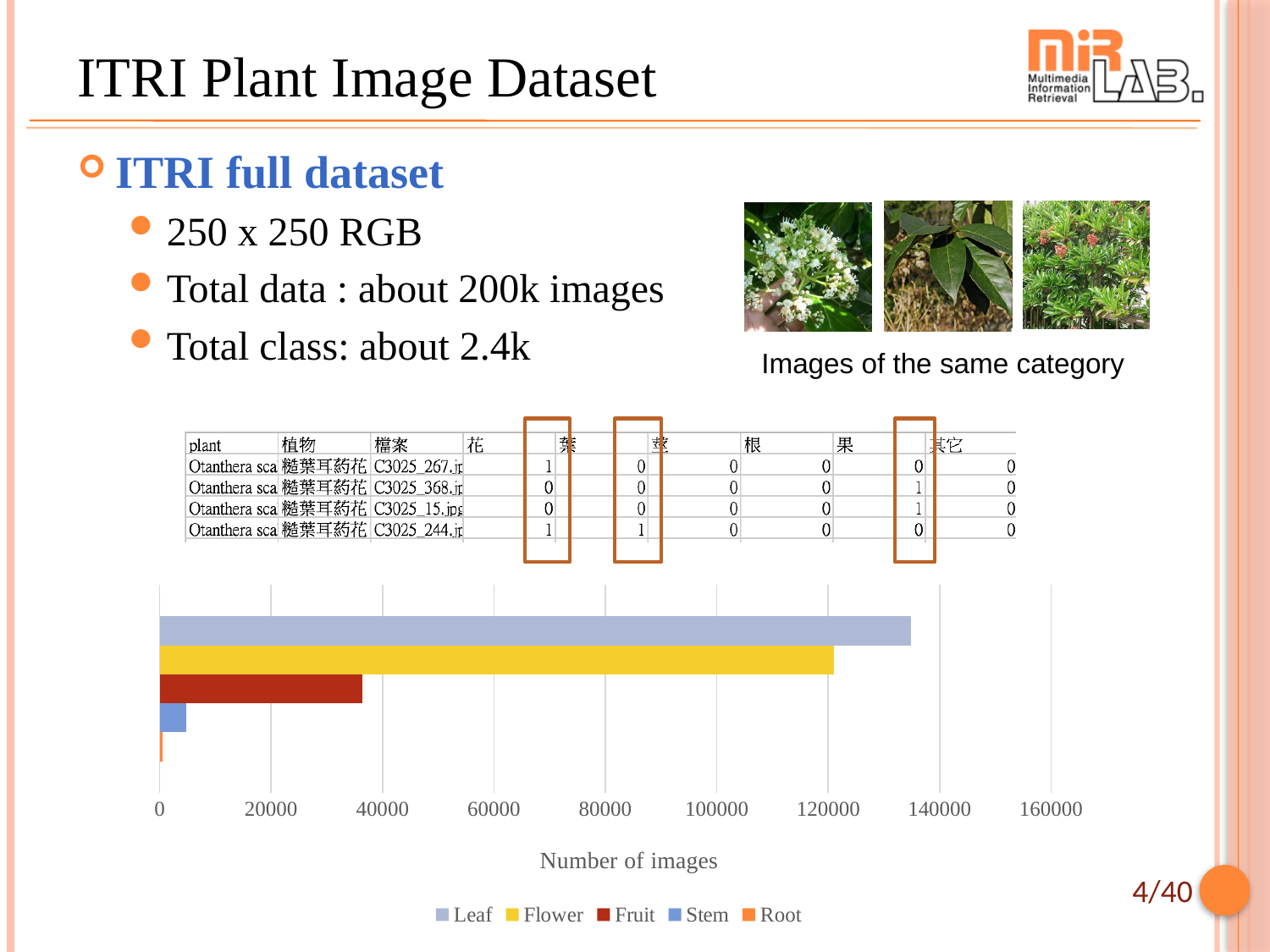
Is the value for Fruit greater or less than 20000? greater Which series has the highest number of images in the bar chart? Leaf Is the value for Leaf greater or less than 120000? greater What colour represents Flower in the bar chart legend? yellow Which series has the lowest number of images in the bar chart? Root Which has more images, Stem or Fruit? Fruit Is the value for Stem greater or less than 20000? less How many series does the legend of the bar chart list? 5 Which has more images, Flower or Fruit? Flower What kind of chart is shown on the slide? bar chart What is the label of the horizontal axis of the bar chart? Number of images